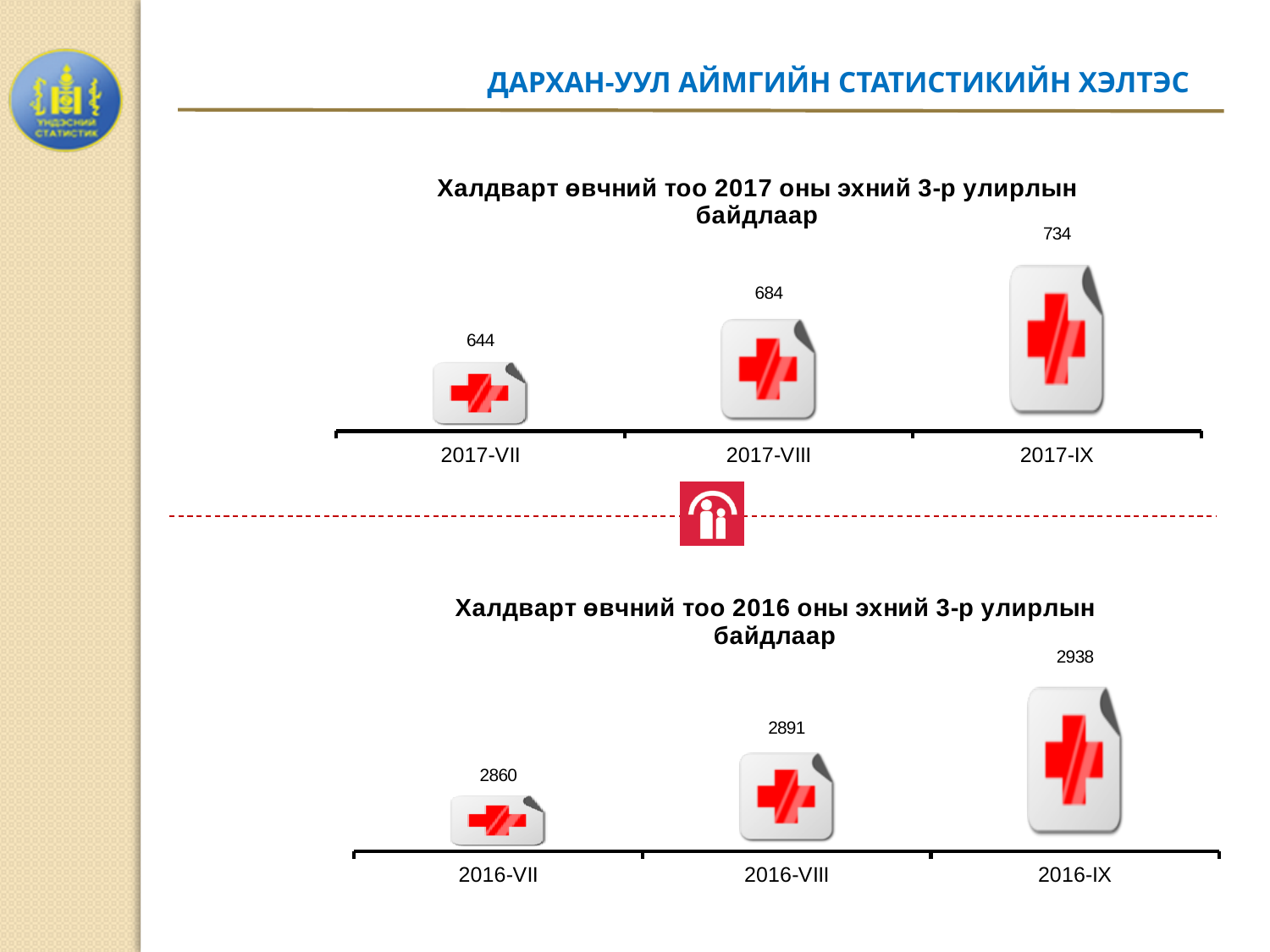
In the bottom chart (2016), which month has the lowest value? 2016-VII In the top chart (2017), do the values rise or fall from 2017-VII to 2017-IX? rise In the bottom chart (2016), what is the value for 2016-IX? 2938 In the bottom chart (2016), what is the difference between the values for 2016-VIII and 2016-VII? 31 How many categories are shown in the bottom chart (2016)? 3 In the bottom chart (2016), what is the value for 2016-VIII? 2891 In the top chart (2017), what is the difference between the values for 2017-IX and 2017-VII? 90 In the top chart (2017), what is the value for 2017-IX? 734 What is the title of the bottom chart? Халдварт өвчний тоо 2016 оны эхний 3-р улирлын байдлаар In the top chart (2017), which is larger, the value for 2017-VIII or 2017-VII? 2017-VIII In the top chart (2017), what is the value for 2017-VII? 644 In the top chart (2017), which month has the highest value? 2017-IX